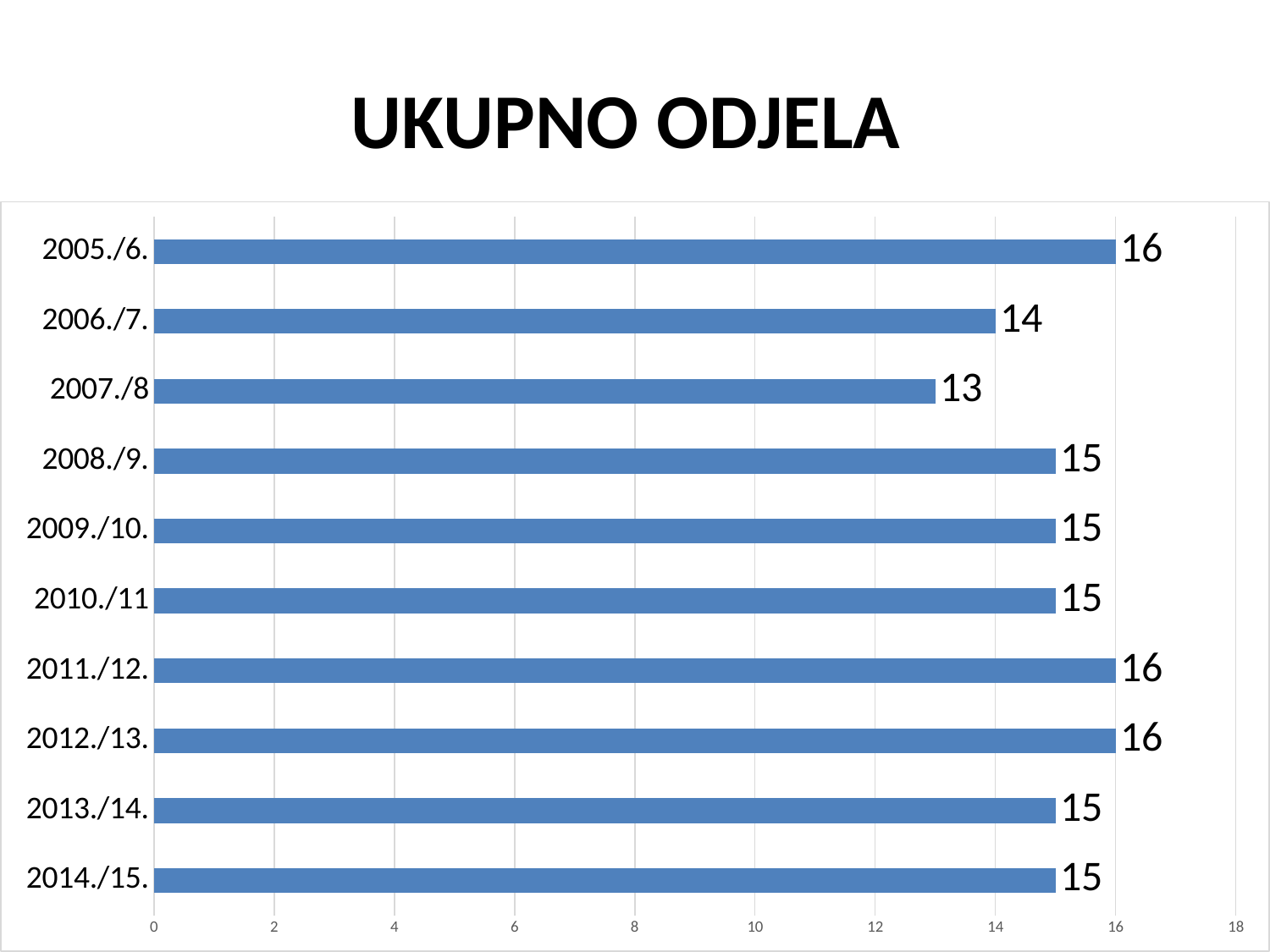
Which is larger, the value for 2011./12. or the value for 2013./14.? 2011./12. What is the value for 2005./6.? 16 What is the title of the chart? UKUPNO ODJELA How many categories are shown in the chart? 10 What is the value for 2007./8? 13 What kind of chart is shown on the slide? bar chart What is the difference between the values for 2005./6. and 2007./8? 3 Is the value for 2007./8 greater or less than 14? less What is the difference between the values for 2006./7. and 2008./9.? 1 What is the value for 2006./7.? 14 Which category has the lowest value? 2007./8 What is the value for 2014./15.? 15